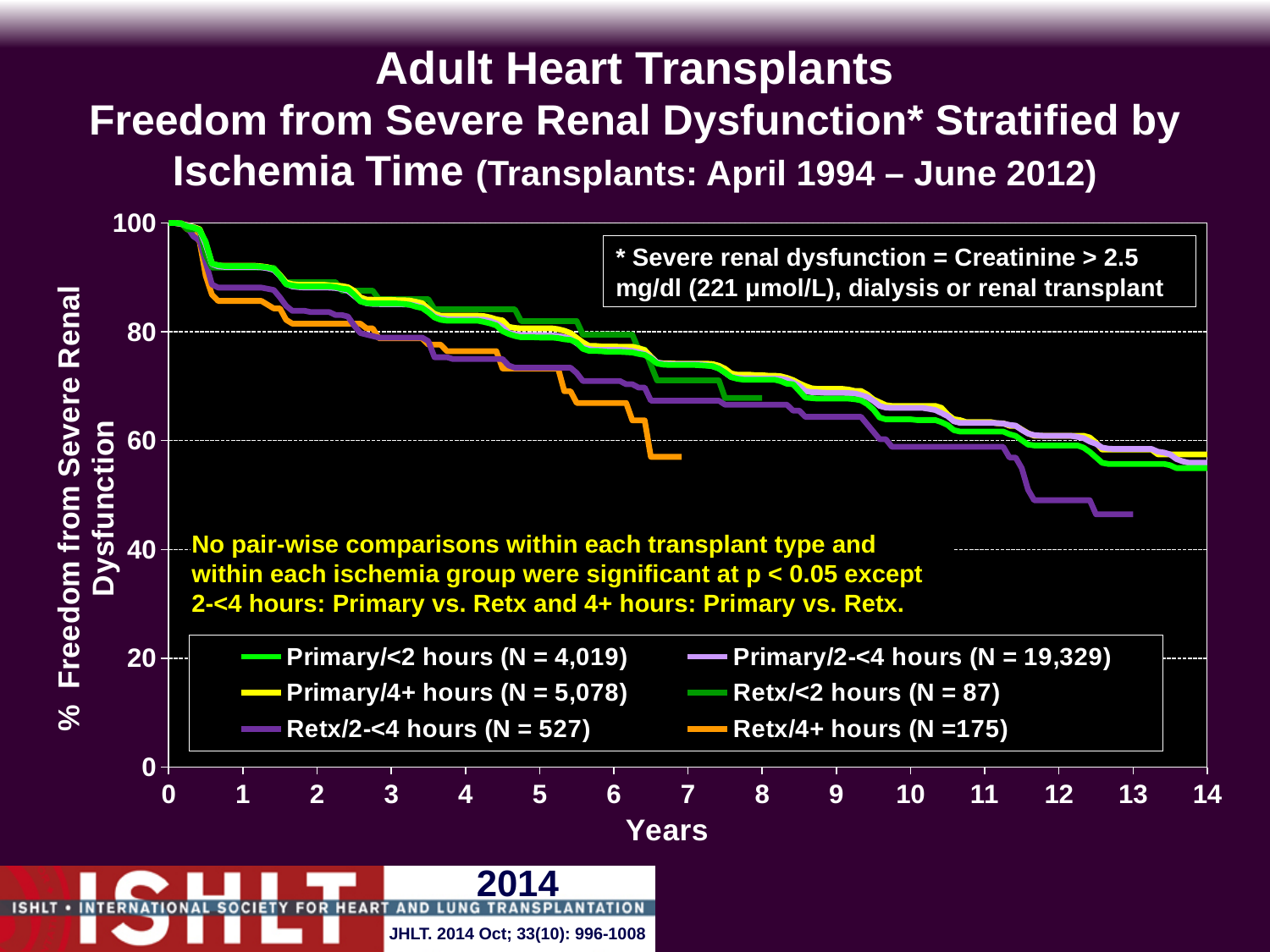
At year 6, which is higher: Primary/4+ hours or Retx/4+ hours? Primary/4+ hours What is the N for the Primary/2-<4 hours group shown in the legend? 19,329 At year 13, which is higher: Primary/2-<4 hours or Retx/2-<4 hours? Primary/2-<4 hours Do the curves rise or fall as the years increase along the x axis? fall Is the value for Retx/2-<4 hours at year 13 greater or less than 40? greater Is the value for Retx/4+ hours at year 5 greater or less than 80? less Is the value for Primary/<2 hours at year 1 greater or less than 80? greater What kind of chart is shown on the slide? line chart According to the footnote on the chart, severe renal dysfunction is defined as creatinine greater than what value in mg/dl? 2.5 mg/dl How many series does the legend list? 6